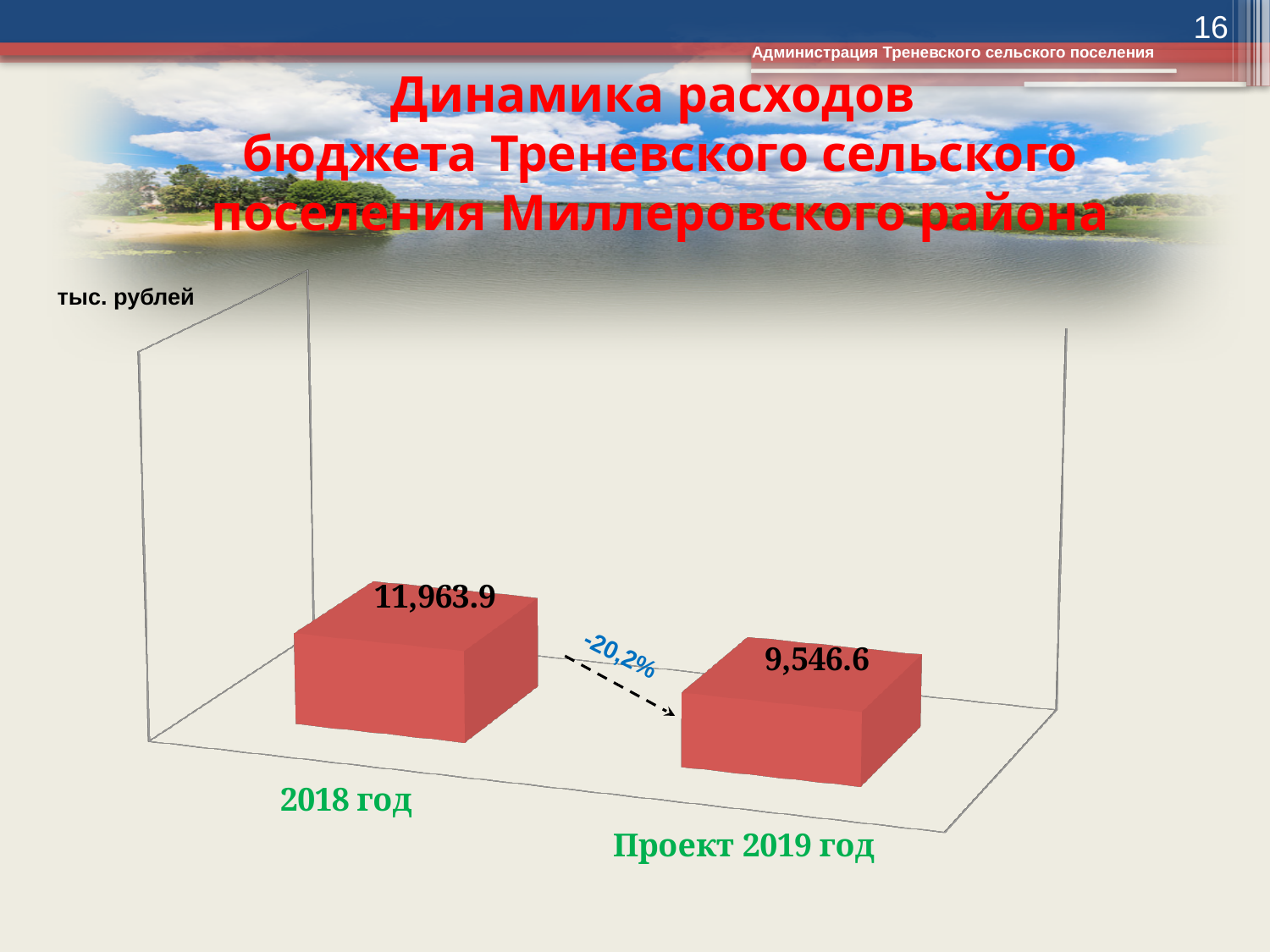
In what units are the chart values expressed, according to the label in the top-left of the chart? тыс. рублей Which category has the higher value, 2018 год or Проект 2019 год? 2018 год What percentage change is annotated between the two bars? -20,2% Do the values rise or fall from 2018 год to Проект 2019 год? Fall Which category has the lowest value on the chart? Проект 2019 год What is the value shown for 2018 год? 11,963.9 Which category has the highest value on the chart? 2018 год What is the value shown for Проект 2019 год? 9,546.6 What is the difference between the value for 2018 год and the value for Проект 2019 год? 2,417.3 What kind of chart is shown on the slide? Bar chart How many categories (bars) are plotted on the chart? 2